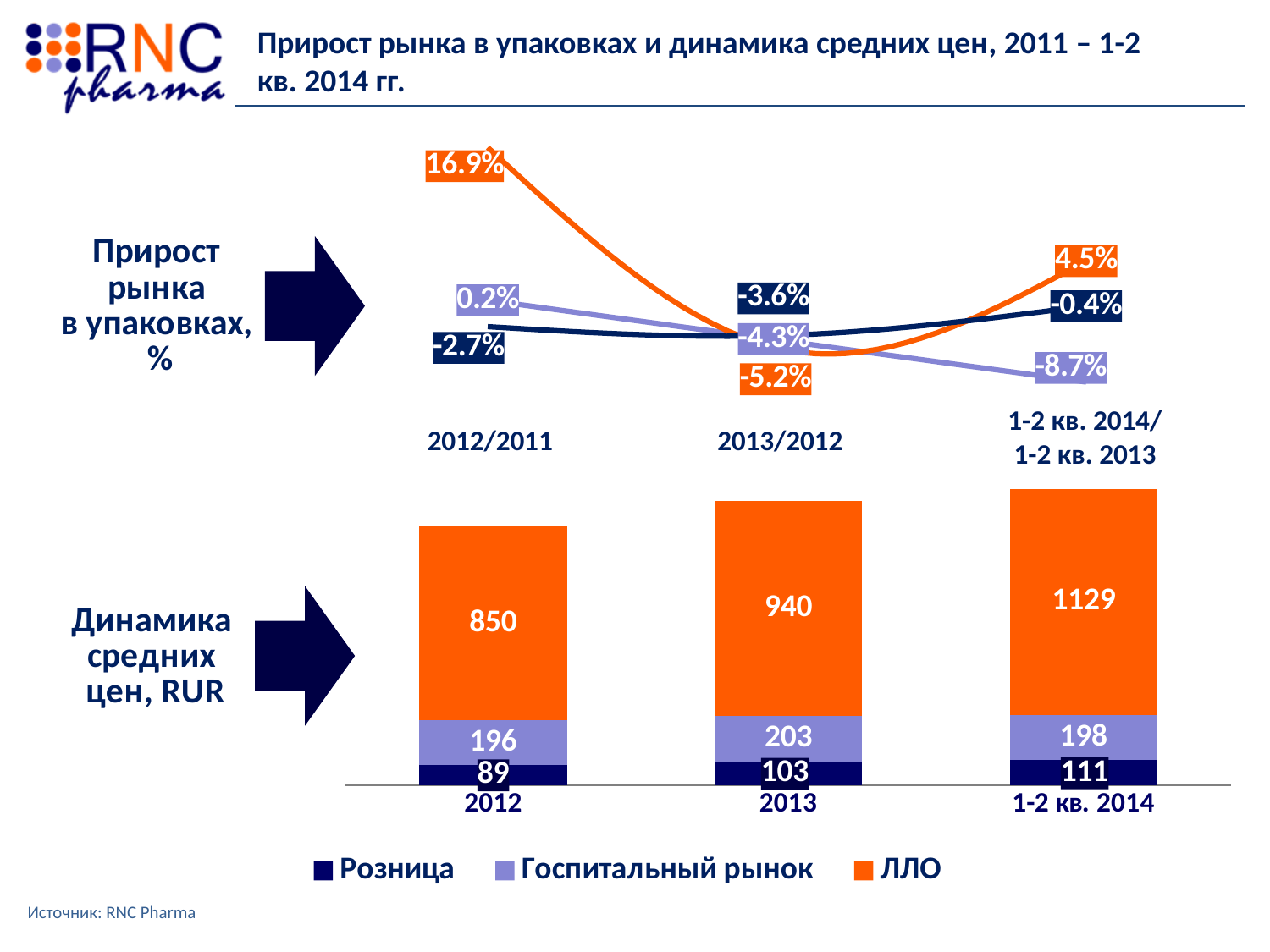
What kind of chart is the bottom chart (Динамика средних цен, RUR)? stacked bar chart How many series does the legend list? 3 In the top chart (Прирост рынка в упаковках, %), does the ЛЛО line rise or fall from 2012/2011 to 2013/2012? fall In the bottom chart (Динамика средних цен, RUR), what is the total of the stacked bar for 1-2 кв. 2014? 1438 In the top chart (Прирост рынка в упаковках, %), what is the value for Розница in 2013/2012? -3.6% In the bottom chart (Динамика средних цен, RUR), which is larger: Госпитальный рынок in 2013 or in 1-2 кв. 2014? 2013 In the bottom chart (Динамика средних цен, RUR), what is the difference between the ЛЛО values for 1-2 кв. 2014 and 2012? 279 In the bottom chart (Динамика средних цен, RUR), what is the value for ЛЛО in 2013? 940 In the bottom chart (Динамика средних цен, RUR), what is the value for Розница in 2012? 89